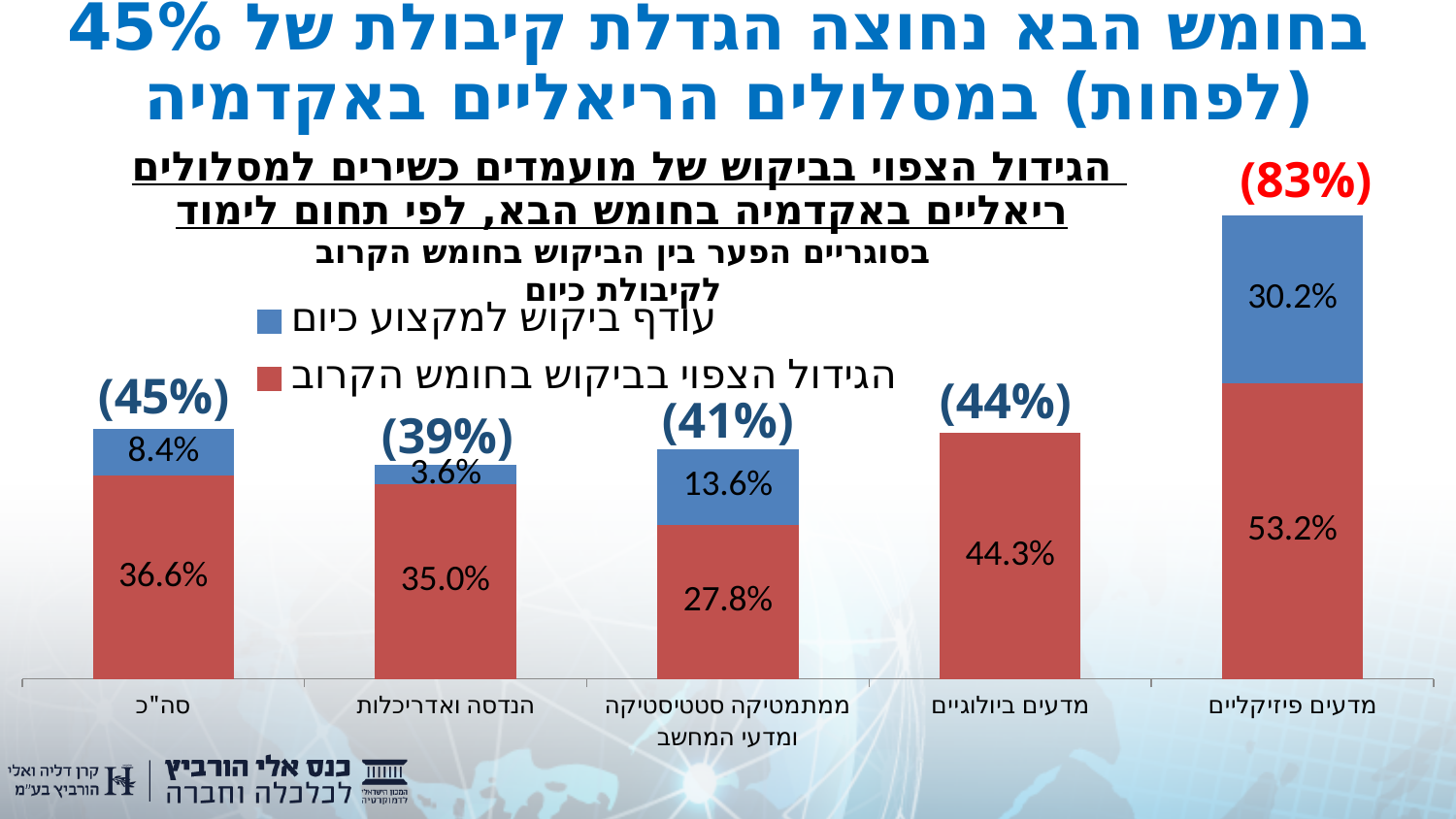
Which category has the lowest total bar? הנדסה ואדריכלות What is the difference between the red series values for סה"כ (36.6%) and הנדסה ואדריכלות (35.0%)? 1.6% What type of chart is shown on the slide? stacked bar chart What is the value of the red series (הגידול הצפוי בביקוש בחומש הקרוב) for מדעים פיזיקליים? 53.2% Which is larger: the blue series value for סה"כ or for הנדסה ואדריכלות? סה"כ Which category has the highest total bar? מדעים פיזיקליים What is the value of the blue series (עודף ביקוש למקצוע כיום) for מתמטיקה סטטיסטיקה ומדעי המחשב? 13.6% How many categories are shown on the x axis of the chart? 5 What is the total shown above the bar for מדעים פיזיקליים? (83%) How many series does the chart legend list? 2 What is the value of the red series for מדעים ביולוגיים? 44.3% What is the total shown above the bar for הנדסה ואדריכלות? (39%)